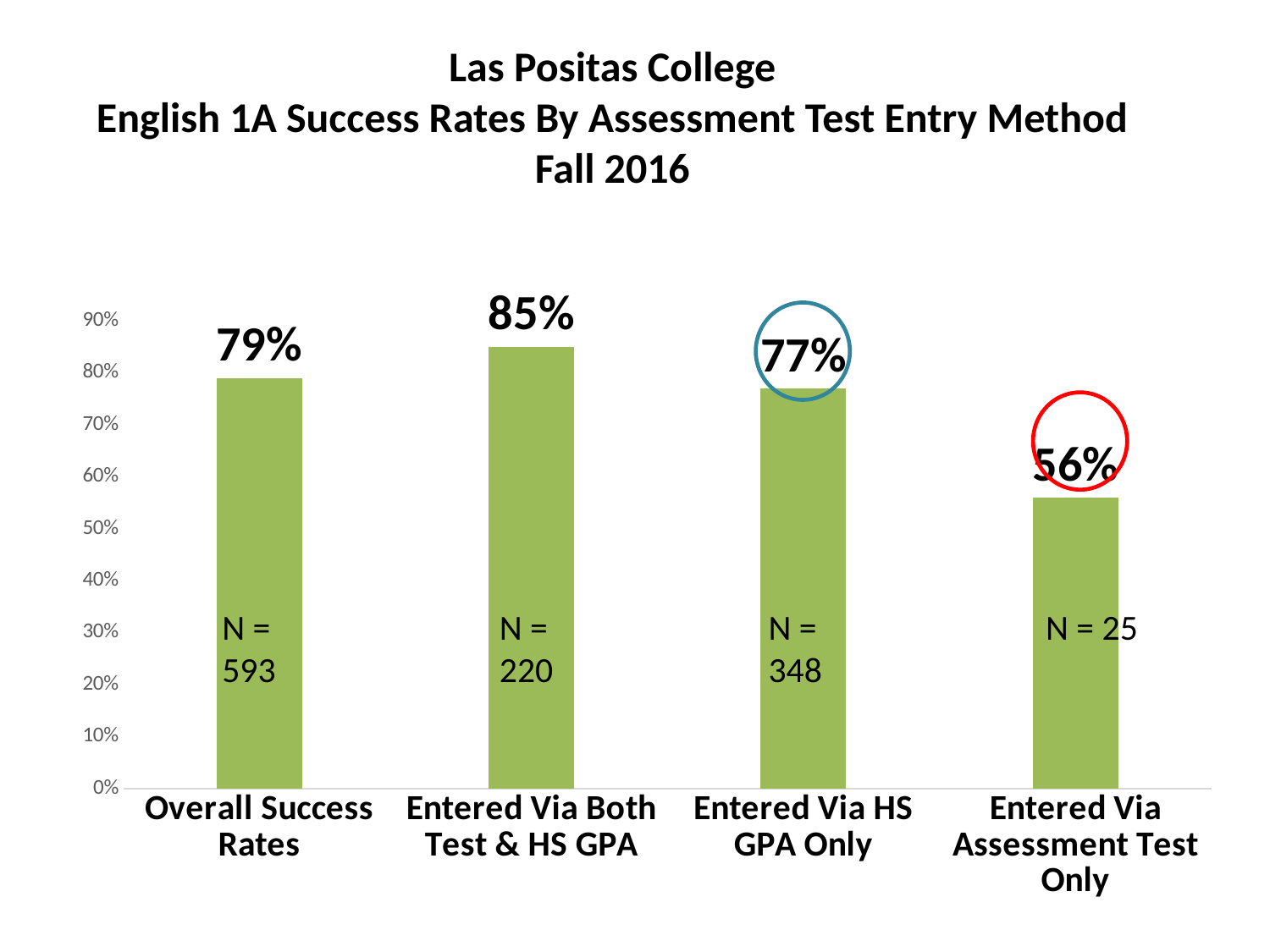
Is the success rate for Entered Via Assessment Test Only greater or less than 60%? less What is the N value for the Overall Success Rates bar? 593 Which has a higher success rate: Entered Via HS GPA Only or Entered Via Assessment Test Only? Entered Via HS GPA Only What is the success rate for students who Entered Via Both Test & HS GPA? 85% What kind of chart is shown on the slide? bar chart What is the Overall Success Rate shown on the chart? 79% Which category has the lowest success rate? Entered Via Assessment Test Only Which entry method category has the highest success rate? Entered Via Both Test & HS GPA What is the success rate for students who Entered Via Assessment Test Only? 56% What is the difference in success rate between Entered Via Both Test & HS GPA and Entered Via Assessment Test Only? 29% How many categories are shown on the chart? 4 What is the N value for the Entered Via HS GPA Only group? 348